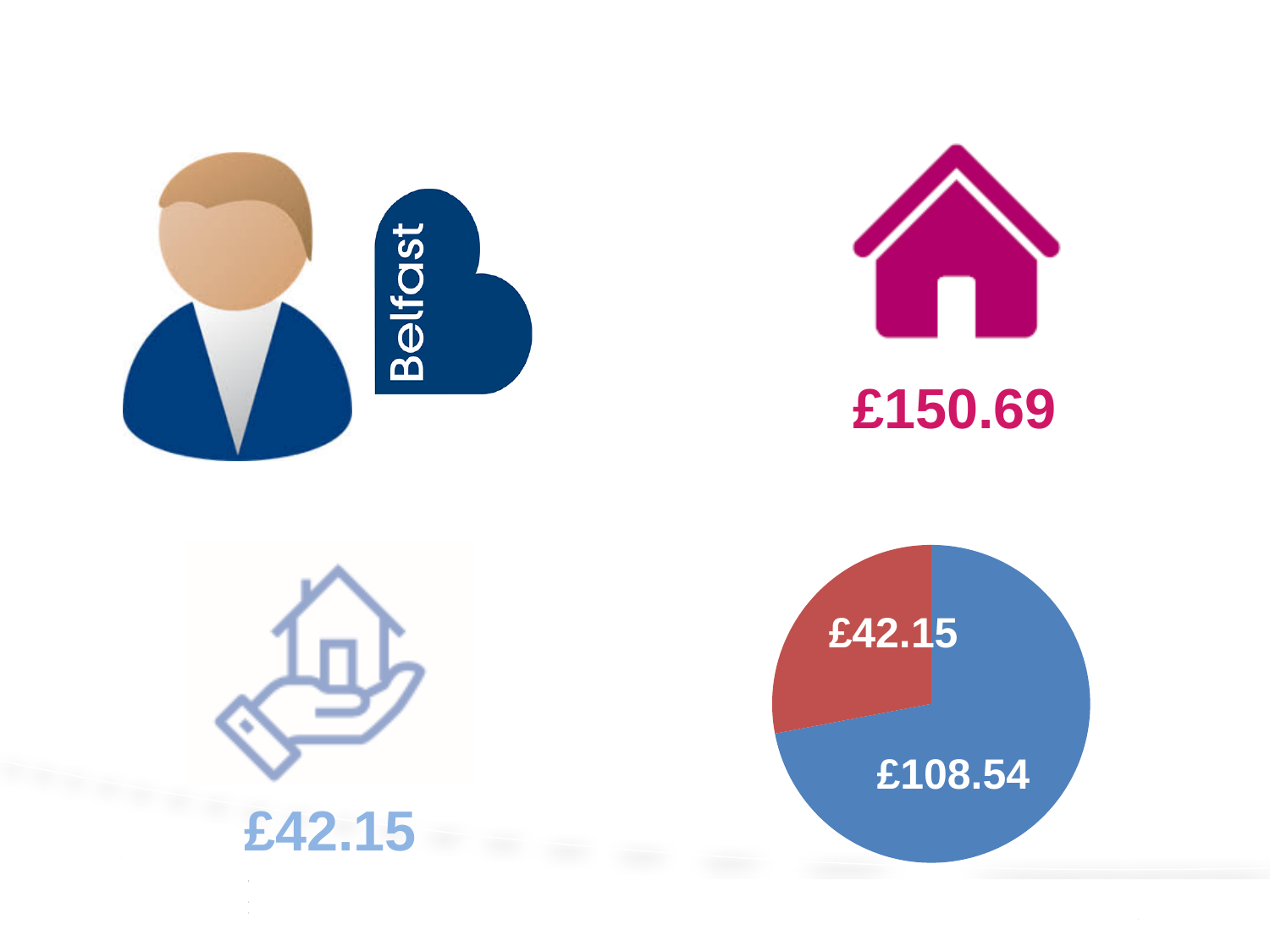
What colour is the slice labelled £42.15 in the pie chart? red What colour is the slice labelled £108.54 in the pie chart? blue Which slice of the pie chart has the smallest value? the red slice (£42.15) What is the difference between the blue slice and the red slice in the pie chart? £66.39 Is the red slice or the blue slice of the pie chart larger? the blue slice What is the total of the two slices in the pie chart? £150.69 What value is labelled on the red slice of the pie chart? £42.15 What value is labelled on the blue slice of the pie chart? £108.54 What kind of chart is shown on the slide? pie chart How many slices does the pie chart have? 2 Which slice of the pie chart has the largest value? the blue slice (£108.54)